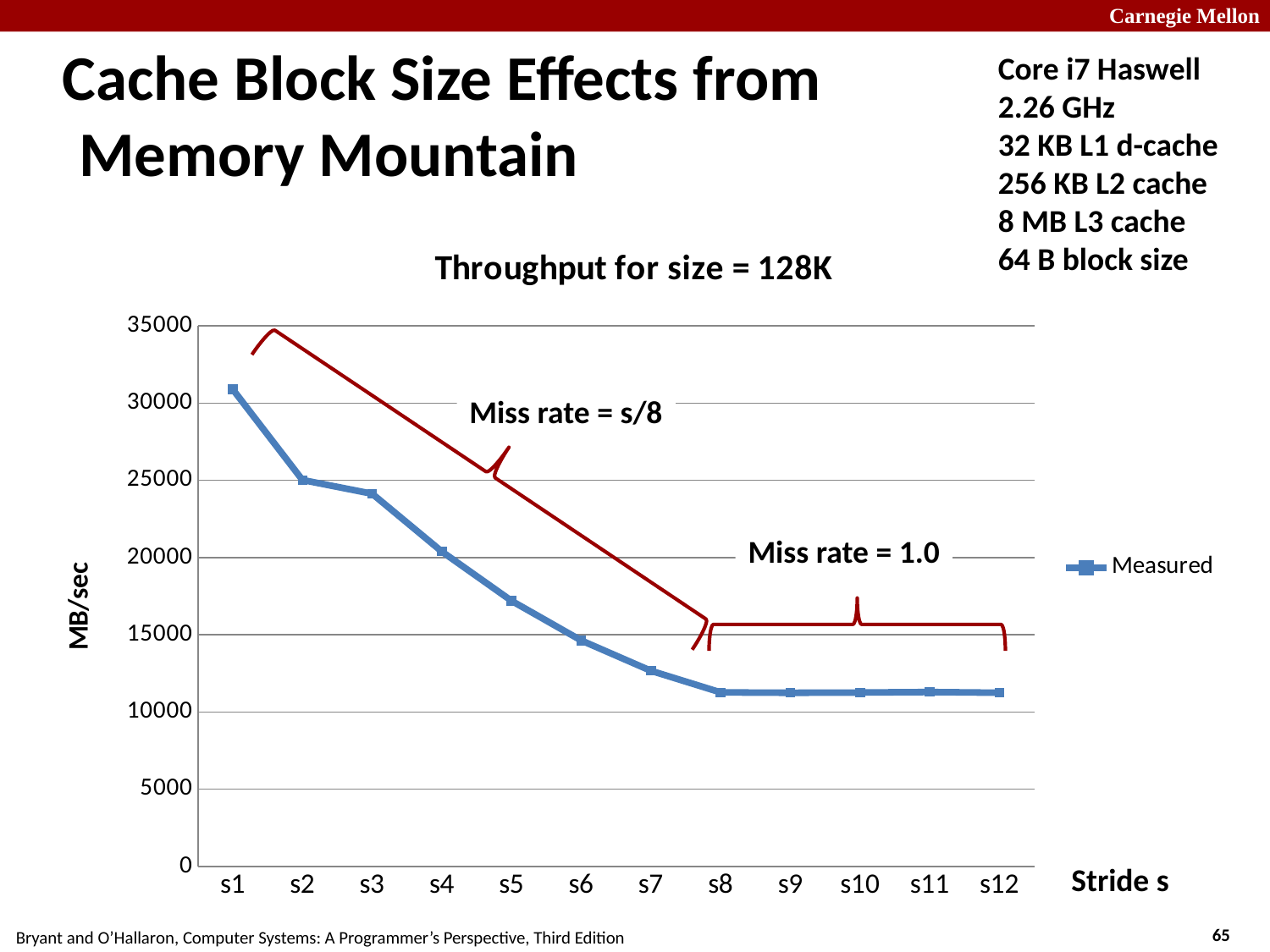
Which has the larger measured throughput, s2 or s5? s2 What is the label on the y axis of the chart? MB/sec Is the measured value for s5 greater or less than 20000? less Is the measured value for s1 greater or less than 30000? greater Is the measured value for s10 greater or less than 10000? greater Do the measured throughput values rise or fall as the stride increases from s1 to s8? fall Which stride has the highest measured throughput? s1 How many stride categories are plotted along the x axis? 12 How many series does the legend list? 1 What is the title of the chart? Throughput for size = 128K What kind of chart is shown on the slide? line chart